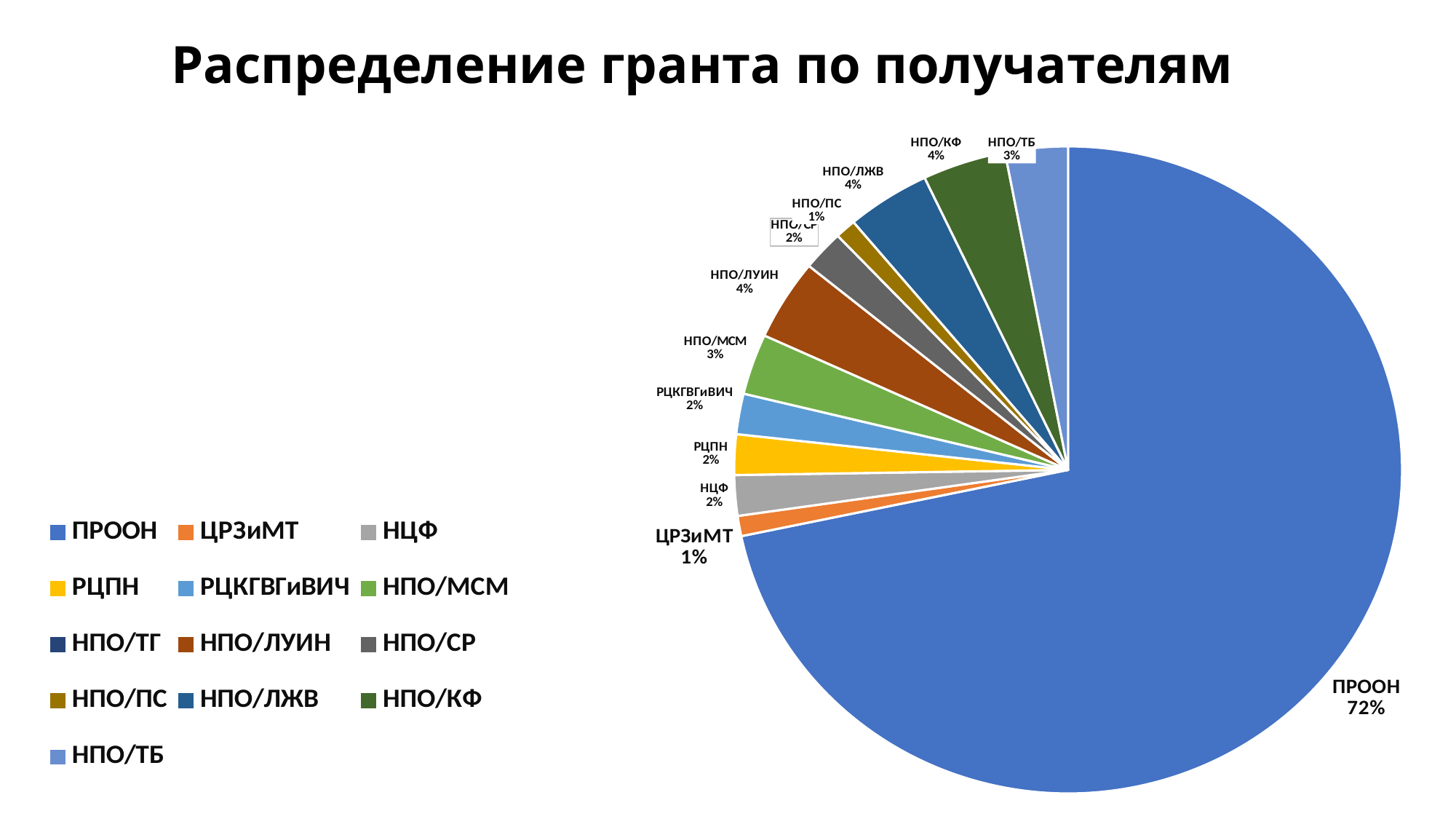
What share of the grant goes to РЦКГВГиВИЧ? 2% How many entries does the legend list? 13 What share of the grant goes to НПО/ТБ? 3% What kind of chart is shown on the slide? pie chart What share of the grant goes to ЦРЗиМТ? 1% What share of the grant goes to НПО/МСМ? 3% Which recipient has the largest share of the grant? ПРООН What is the difference in percentage points between the shares of ПРООН and НПО/ЛЖВ? 68 What share of the grant goes to НПО/ЛУИН? 4% What share of the grant goes to ПРООН? 72% Which has a larger share, ПРООН or НПО/КФ? ПРООН What is the title of the chart? Распределение гранта по получателям